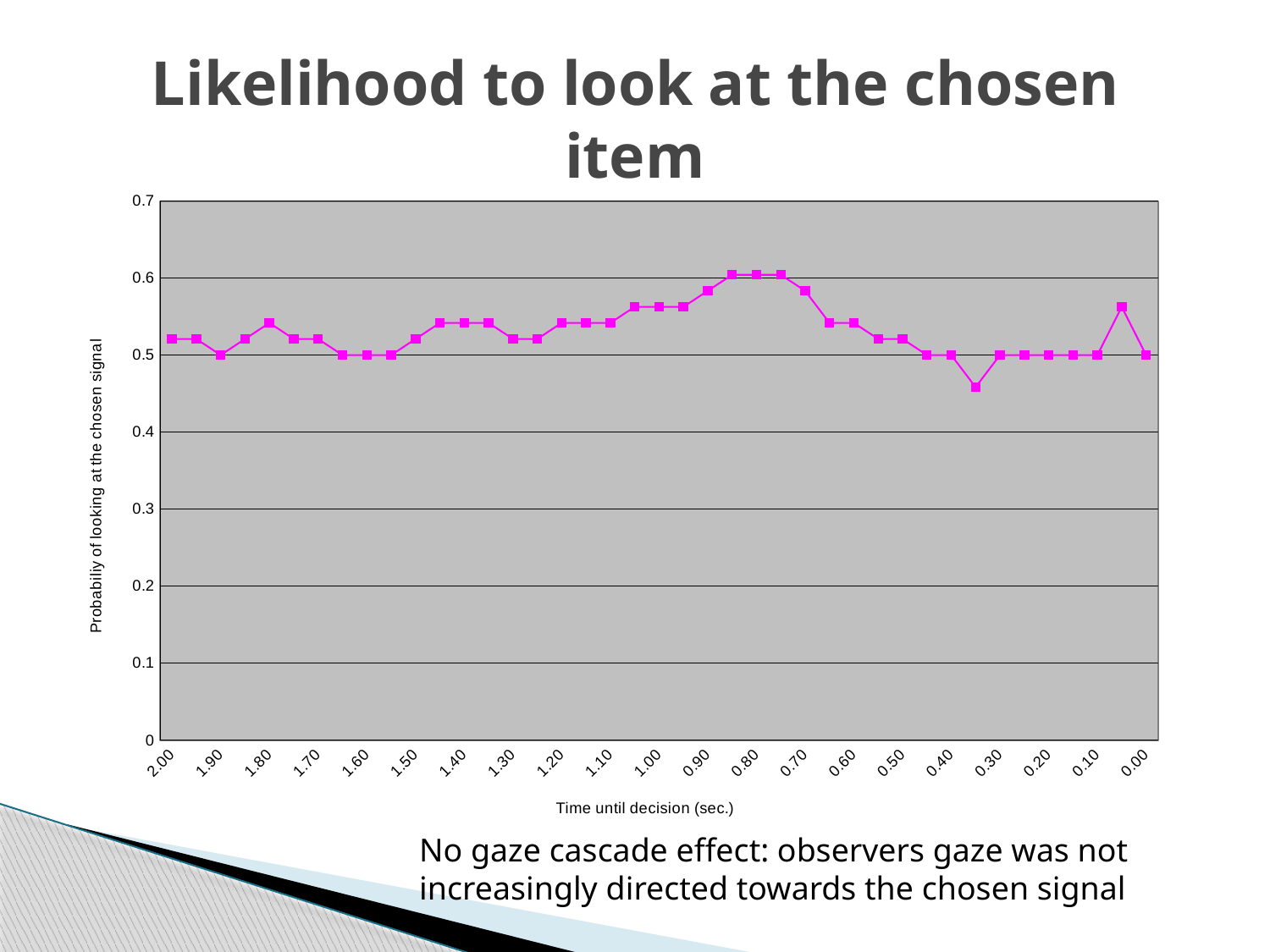
What is the title of the chart? Likelihood to look at the chosen item Which has the larger value, 2.00 seconds or the point between 0.40 and 0.30 seconds? 2.00 Which has the larger value, 0.80 seconds or 1.60 seconds? 0.80 What is the label of the x axis? Time until decision (sec.) Between which two labeled times on the x axis does the lowest point of the line occur? between 0.40 and 0.30 Is the lowest point on the line greater or less than 0.5? less What is the plotted value at 0.00 seconds? 0.5 Is the value at 1.80 seconds greater or less than 0.6? less What is the plotted value at 1.60 seconds? 0.5 Is the value at 0.80 seconds greater or less than 0.5? greater What kind of chart is shown on the slide? line chart How many time labels are shown along the x axis? 21